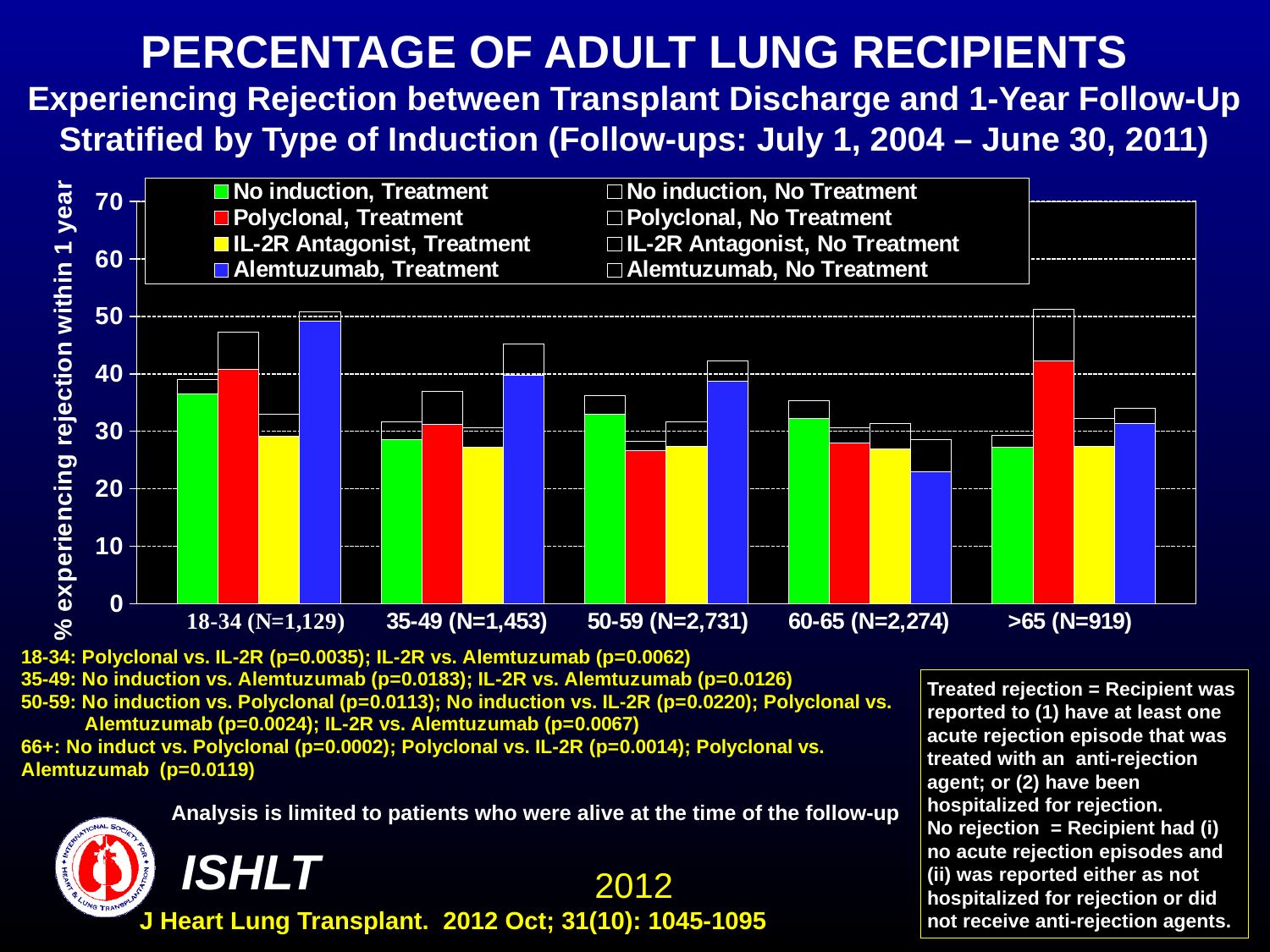
How many age-group categories are shown on the x axis? 5 Is the value for Alemtuzumab, Treatment in the 18-34 age group greater or less than 40? greater In the >65 age group, which induction type has the highest Treatment value? Polyclonal Is the value for Alemtuzumab, Treatment in the 60-65 age group greater or less than 30? less In the 18-34 age group, which is larger: the Treatment value for Alemtuzumab or for Polyclonal? Alemtuzumab Is the value for No induction, Treatment in the 50-59 age group greater or less than 30? greater What kind of chart is shown on the slide? Stacked bar chart In the 18-34 age group, which induction type has the highest Treatment value? Alemtuzumab How many series does the legend list? 8 What is the N shown for the 50-59 age group? N=2,731 In the 60-65 age group, which induction type has the lowest Treatment value? Alemtuzumab